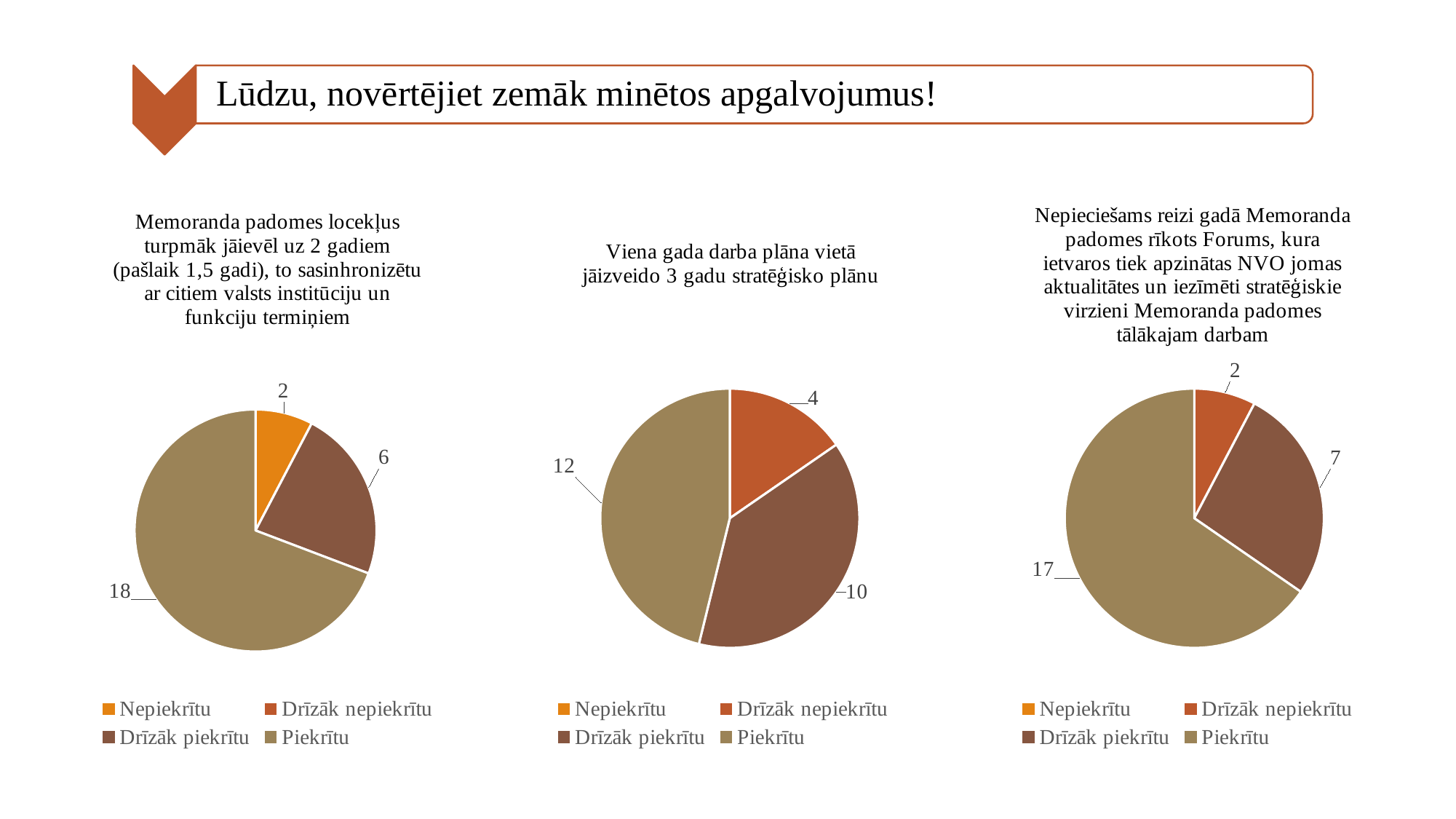
In the middle pie chart, what is the value for Drīzāk piekrītu? 10 What type of chart is the middle chart? Pie chart In the right pie chart, what is the difference between the Piekrītu and Drīzāk piekrītu values? 10 In the middle pie chart, what is the total of all slices? 26 In the left pie chart, which category has the largest slice? Piekrītu In the middle pie chart, which category has the smallest slice? Drīzāk nepiekrītu How many slices does the left pie chart have? 3 In the middle pie chart, which is larger: Piekrītu or Drīzāk piekrītu? Piekrītu In the left pie chart, what share of the total does the Piekrītu slice represent? 18 of 26 In the left pie chart, what is the value for Piekrītu? 18 How many entries does the legend of the right chart list? 4 In the right pie chart, what is the value for Drīzāk nepiekrītu? 2